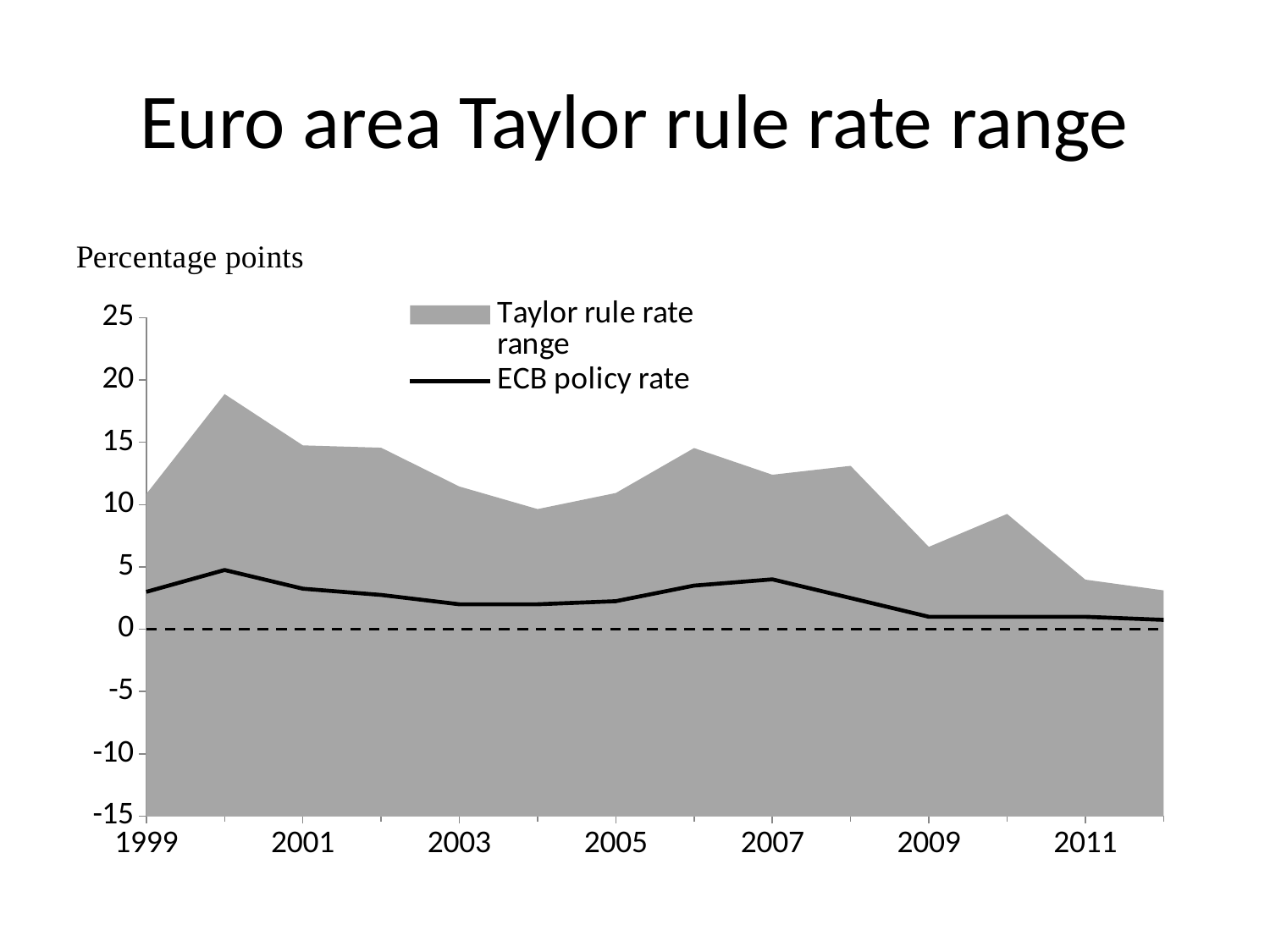
What is the title of the chart? Euro area Taylor rule rate range Is the upper edge of the Taylor rule rate range in 2006 greater or less than 10? greater Is the ECB policy rate in 2007 greater or less than 5? less Is the ECB policy rate in 2009 greater or less than 5? less Which is larger, the ECB policy rate in 2000 or in 2009? 2000 Does the ECB policy rate rise or fall between 2007 and 2009? fall In which year does the upper edge of the Taylor rule rate range reach its highest point? 2000 How many series does the legend list? 2 What unit is shown above the y axis? Percentage points How many year labels are shown on the x axis? 7